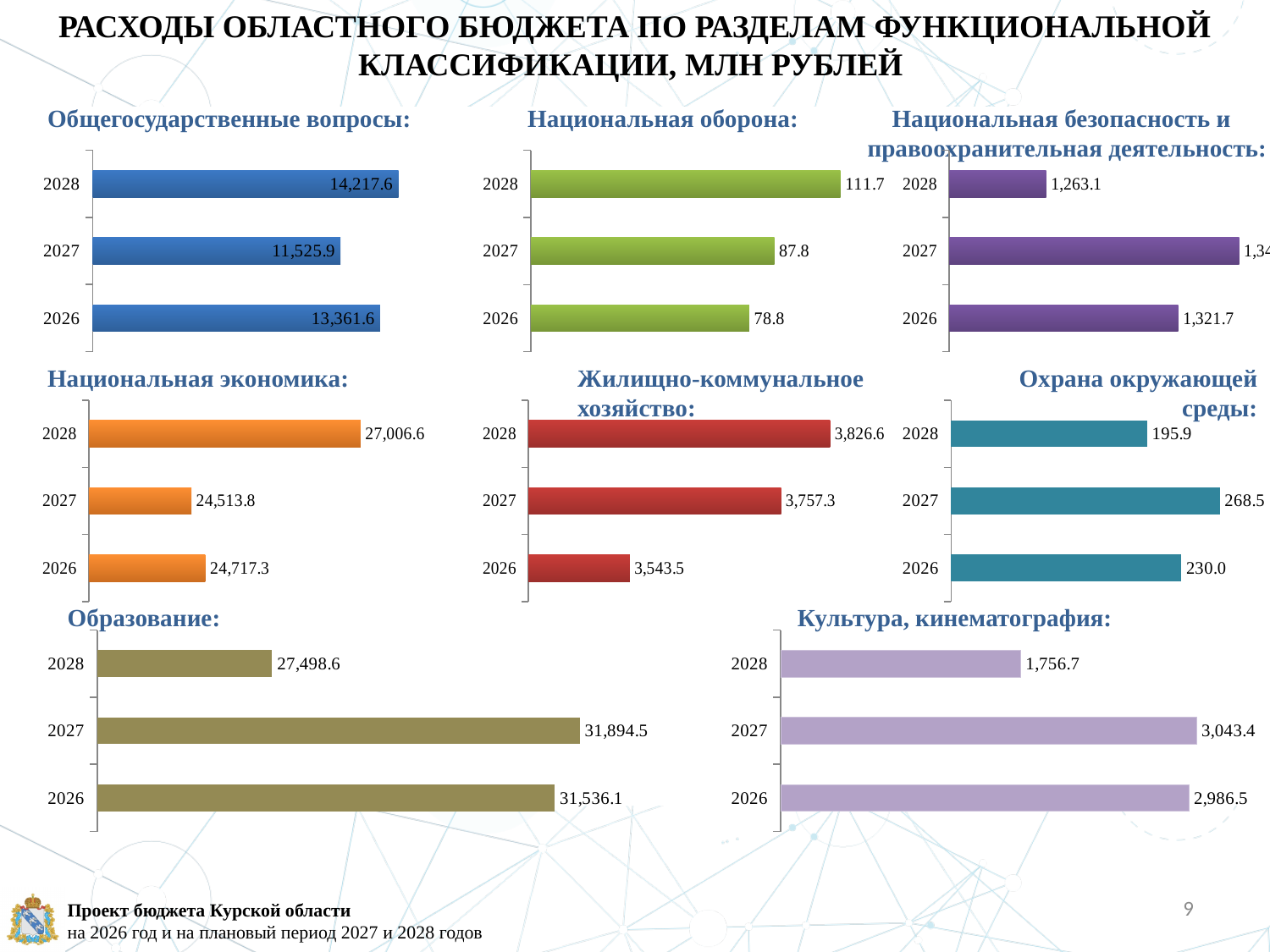
What type of chart is used for 'Жилищно-коммунальное хозяйство'? Bar chart How many years are shown in the 'Национальная экономика' chart? 3 In the 'Образование' chart, which year has the highest value? 2027 In the 'Жилищно-коммунальное хозяйство' chart, do the values rise or fall from 2026 to 2028? Rise In the 'Охрана окружающей среды' chart, which year has the lowest value? 2028 How many separate charts are shown on the slide? 8 In the 'Национальная оборона' chart, what is the value for 2028? 111.7 In the 'Культура, кинематография' chart, which is larger: the value for 2027 or the value for 2028? 2027 In the 'Национальная экономика' chart, what is the value for 2028? 27,006.6 In the 'Национальная оборона' chart, what is the difference between the 2028 and 2026 values? 32.9 In the 'Общегосударственные вопросы' chart, what is the value for 2027? 11,525.9 In the 'Национальная безопасность и правоохранительная деятельность' chart, which year has the longest bar? 2027